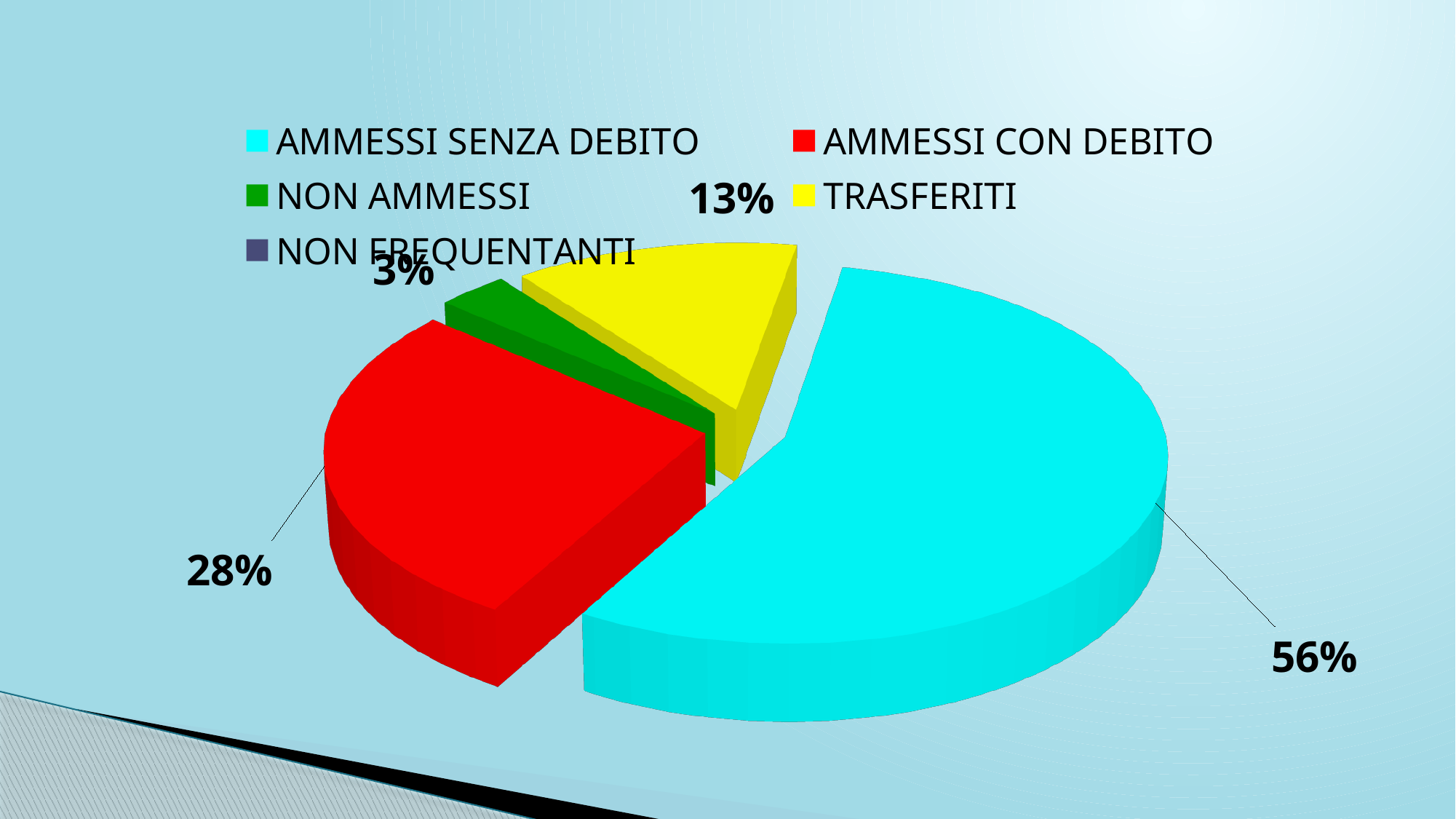
Which category has the largest slice of the pie? AMMESSI SENZA DEBITO How many categories does the legend list? 5 What percentage of the pie is AMMESSI SENZA DEBITO? 56% Which of the labelled slices is the smallest? NON AMMESSI What colour represents TRASFERITI in the chart? Yellow What percentage of the pie is AMMESSI CON DEBITO? 28% What is the combined share of AMMESSI CON DEBITO and TRASFERITI? 41% What percentage of the pie is NON AMMESSI? 3% What percentage of the pie is TRASFERITI? 13% Which is larger, the TRASFERITI slice or the AMMESSI CON DEBITO slice? AMMESSI CON DEBITO What is the difference in percentage points between AMMESSI SENZA DEBITO and AMMESSI CON DEBITO? 28 percentage points What kind of chart is shown on the slide? Pie chart